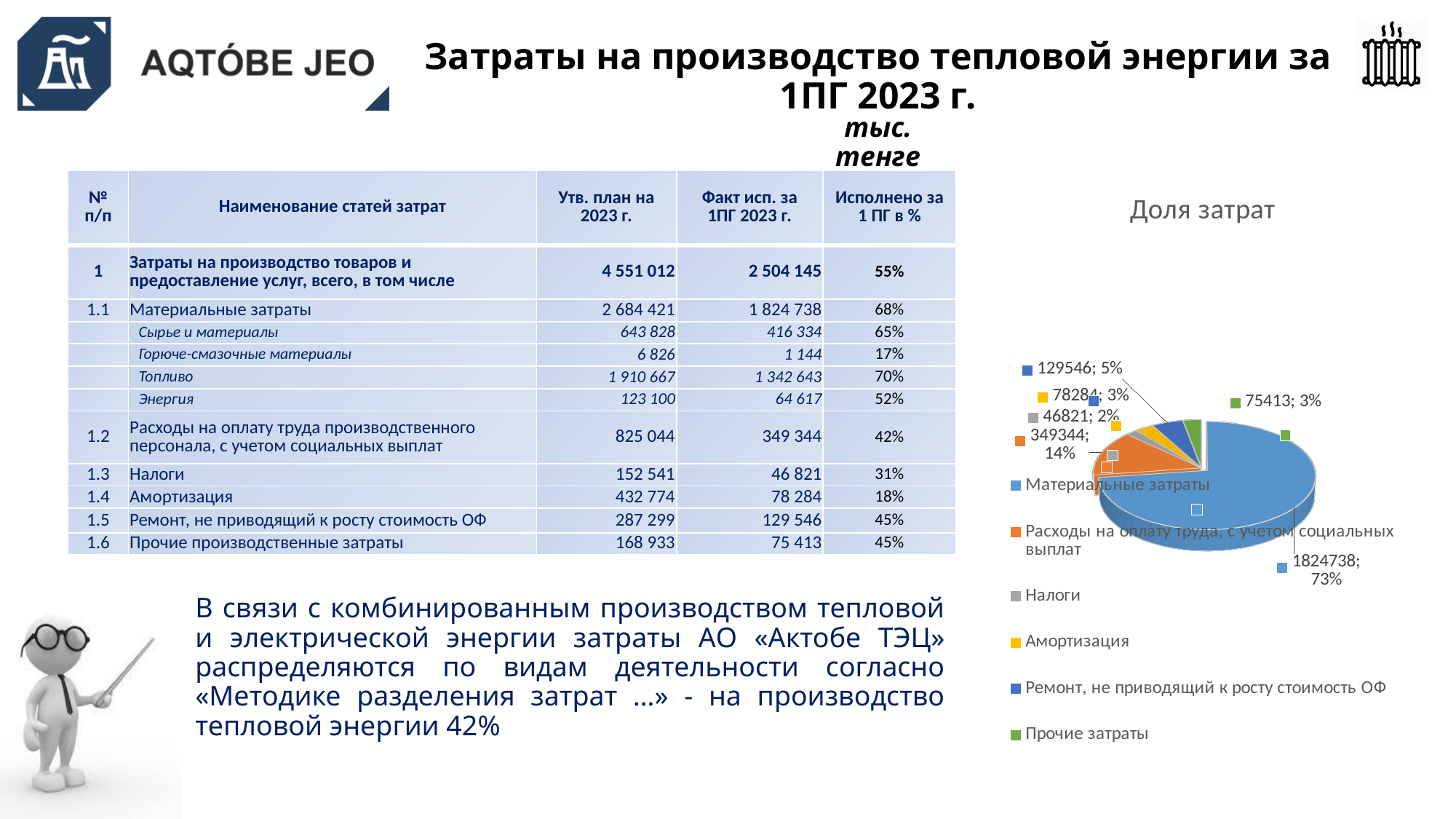
Which category has the smallest slice in the pie chart "Доля затрат"? Налоги In the pie chart "Доля затрат", what value is shown for Ремонт, не приводящий к росту стоимость ОФ? 129546 How many slices does the pie chart "Доля затрат" have? 6 In the pie chart "Доля затрат", what share does Расходы на оплату труда, с учетом социальных выплат have? 14% In the pie chart "Доля затрат", what value is shown for Материальные затраты? 1824738 In the pie chart "Доля затрат", what share does Материальные затраты have? 73% Which category has the largest slice in the pie chart "Доля затрат"? Материальные затраты What kind of chart is shown under the title "Доля затрат"? pie chart In the pie chart "Доля затрат", what is the difference between the values for Амортизация and Прочие затраты? 2871 In the pie chart "Доля затрат", what value is shown for Налоги? 46821 In the pie chart "Доля затрат", which is larger: Амортизация or Ремонт, не приводящий к росту стоимость ОФ? Ремонт, не приводящий к росту стоимость ОФ What is the title of the chart on the slide? Доля затрат